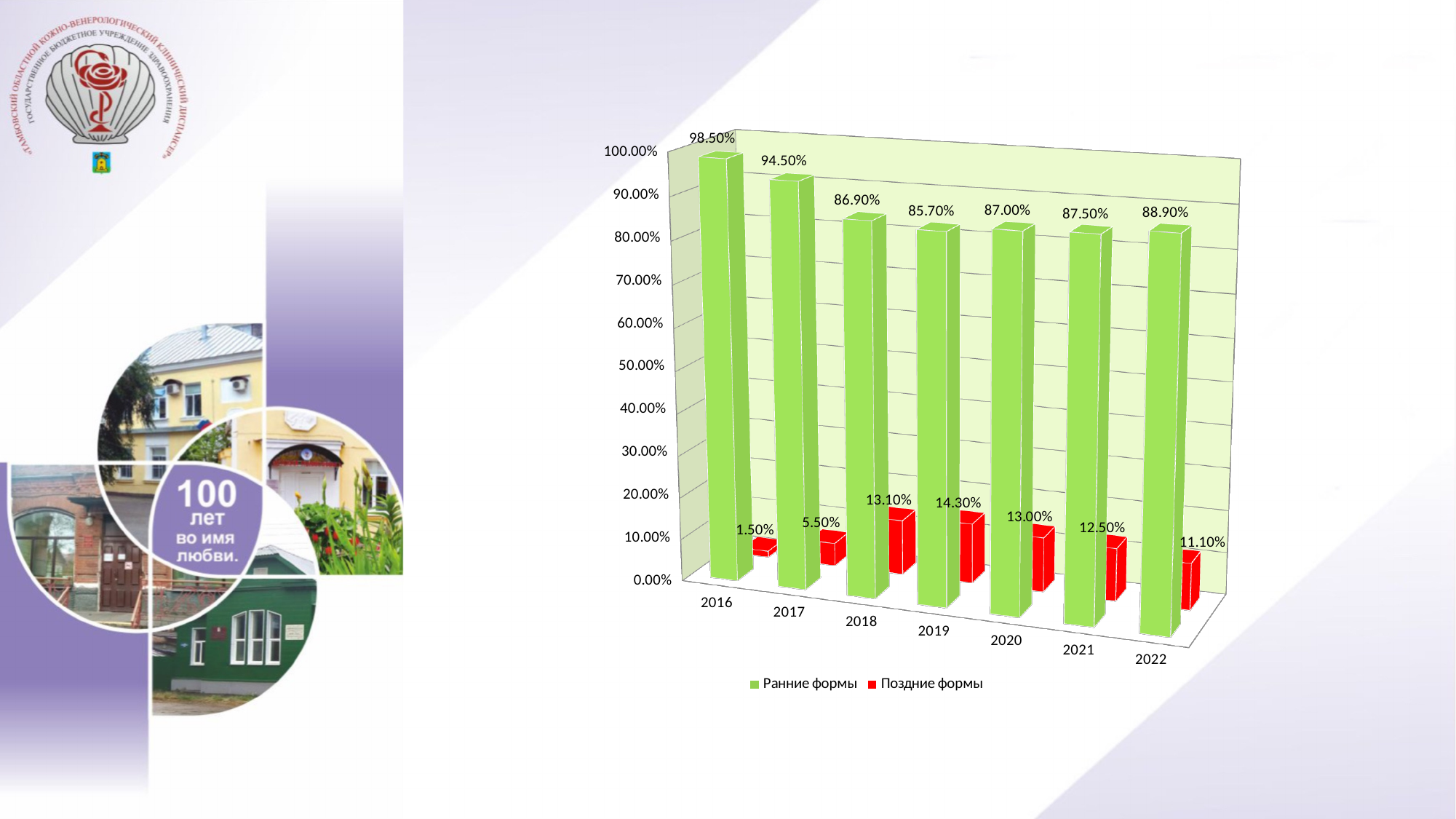
How many years are shown on the x axis? 7 In which year is the value for Поздние формы the highest? 2019 What is the value for Поздние формы in 2017? 5.50% Which is larger: the Поздние формы value for 2018 or for 2022? 2018 What kind of chart is shown on the slide? Bar chart How many series does the legend list? 2 What is the value for Поздние формы in 2019? 14.30% What is the value for Ранние формы in 2016? 98.50% In which year is the value for Поздние формы the lowest? 2016 What is the value for Ранние формы in 2022? 88.90% In which year is the value for Ранние формы the lowest? 2019 What is the difference between the Ранние формы values for 2016 and 2017? 4.00%